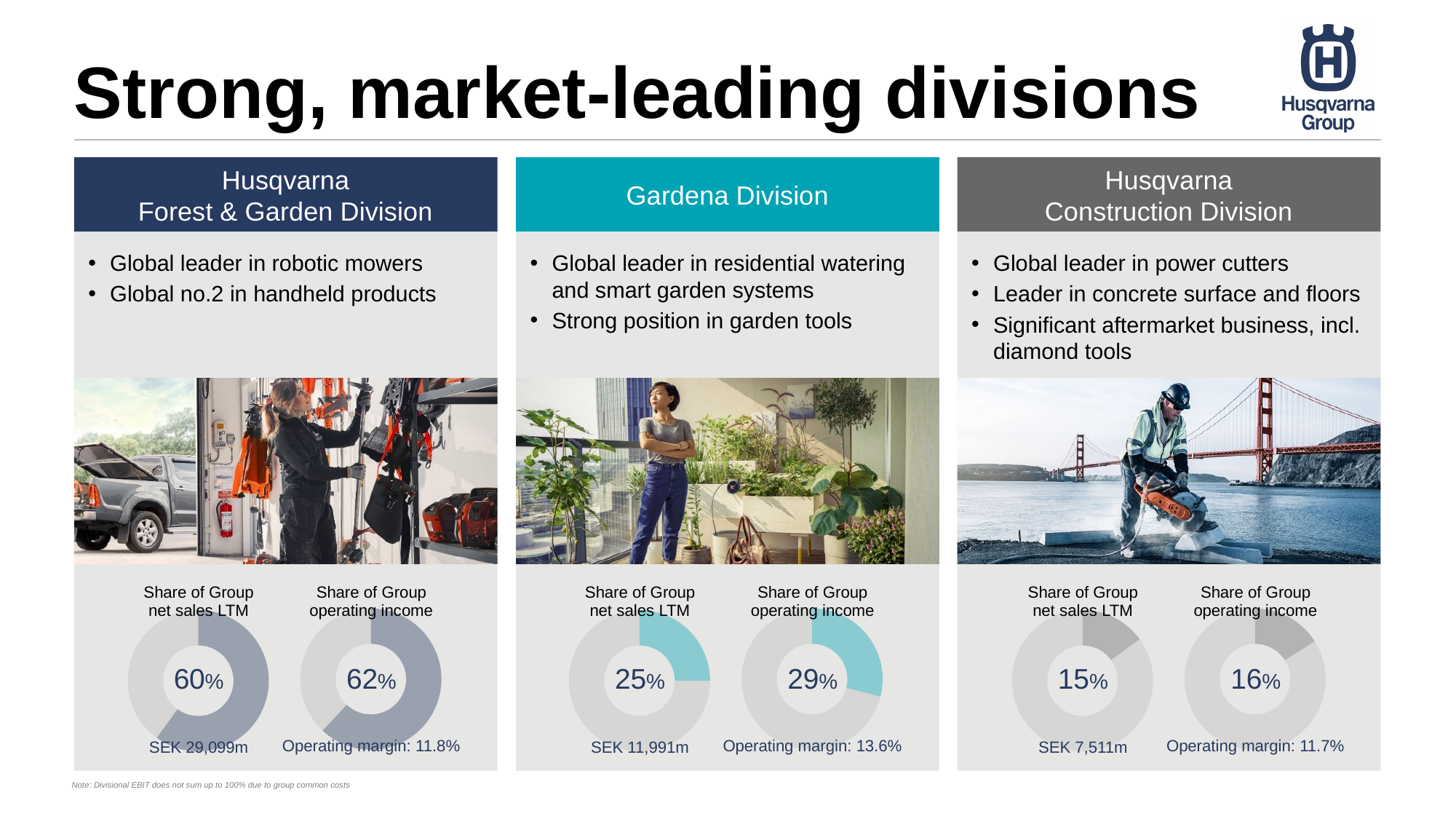
How many donut charts are shown on the slide in total? 6 In the Husqvarna Construction Division's 'Share of Group net sales LTM' donut chart, what share is shown? 15% In the Gardena Division's 'Share of Group operating income' donut chart, what share is shown? 29% Across the three 'Share of Group net sales LTM' donut charts, which division has the highest share? Husqvarna Forest & Garden Division What operating margin is printed below the Husqvarna Forest & Garden Division's 'Share of Group operating income' donut chart? Operating margin: 11.8% What net sales figure is printed below the Gardena Division's 'Share of Group net sales LTM' donut chart? SEK 11,991m What is the difference between the Gardena Division's share of Group operating income and its share of Group net sales LTM, as shown in its two donut charts? 4 percentage points Which is larger: the Husqvarna Forest & Garden Division's share of Group net sales LTM or the Gardena Division's share of Group net sales LTM? Husqvarna Forest & Garden Division What type of chart is used to show the 'Share of Group net sales LTM' for each division? Donut (pie) chart Across the three 'Share of Group operating income' donut charts, which division has the lowest share? Husqvarna Construction Division In the Husqvarna Forest & Garden Division's 'Share of Group net sales LTM' donut chart, what share is shown? 60% In the Husqvarna Construction Division's 'Share of Group operating income' donut chart, what share is shown? 16%